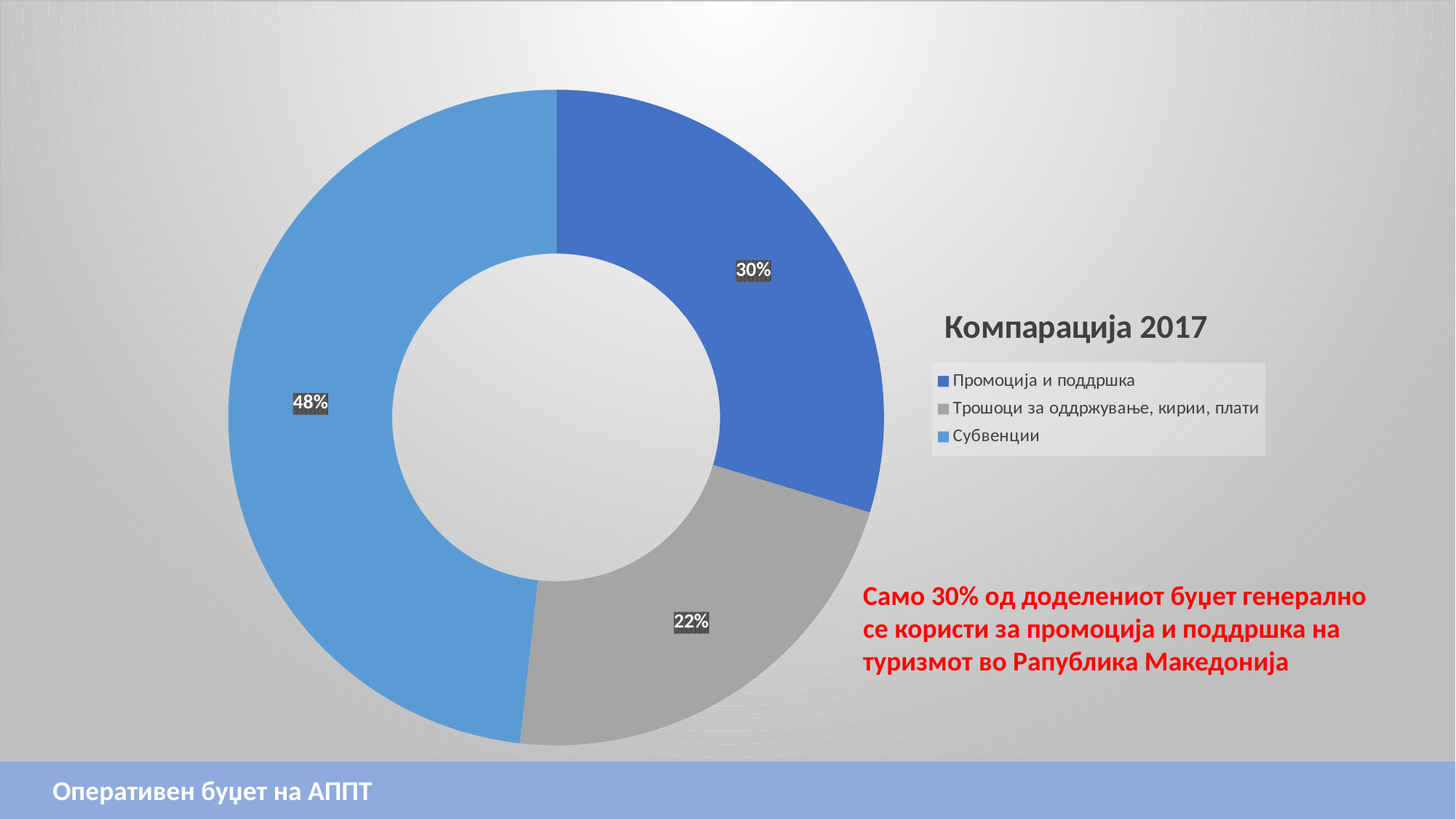
How many categories does the chart show? 3 What colour is the slice for Субвенции? Light blue Which category has the largest share of the chart? Субвенции Which category has the smallest share of the chart? Трошоци за оддржување, кирии, плати What share of the chart does Субвенции represent? 48% What is the combined share of Промоција и поддршка and Трошоци за оддржување, кирии, плати? 52% What kind of chart is shown on the slide? Doughnut (pie) chart What is the title of the chart? Компарација 2017 Which is larger, the share for Промоција и поддршка or the share for Трошоци за оддржување, кирии, плати? Промоција и поддршка What share of the chart does Трошоци за оддржување, кирии, плати represent? 22% What share of the chart does Промоција и поддршка represent? 30% What is the difference in percentage points between Субвенции and Промоција и поддршка? 18